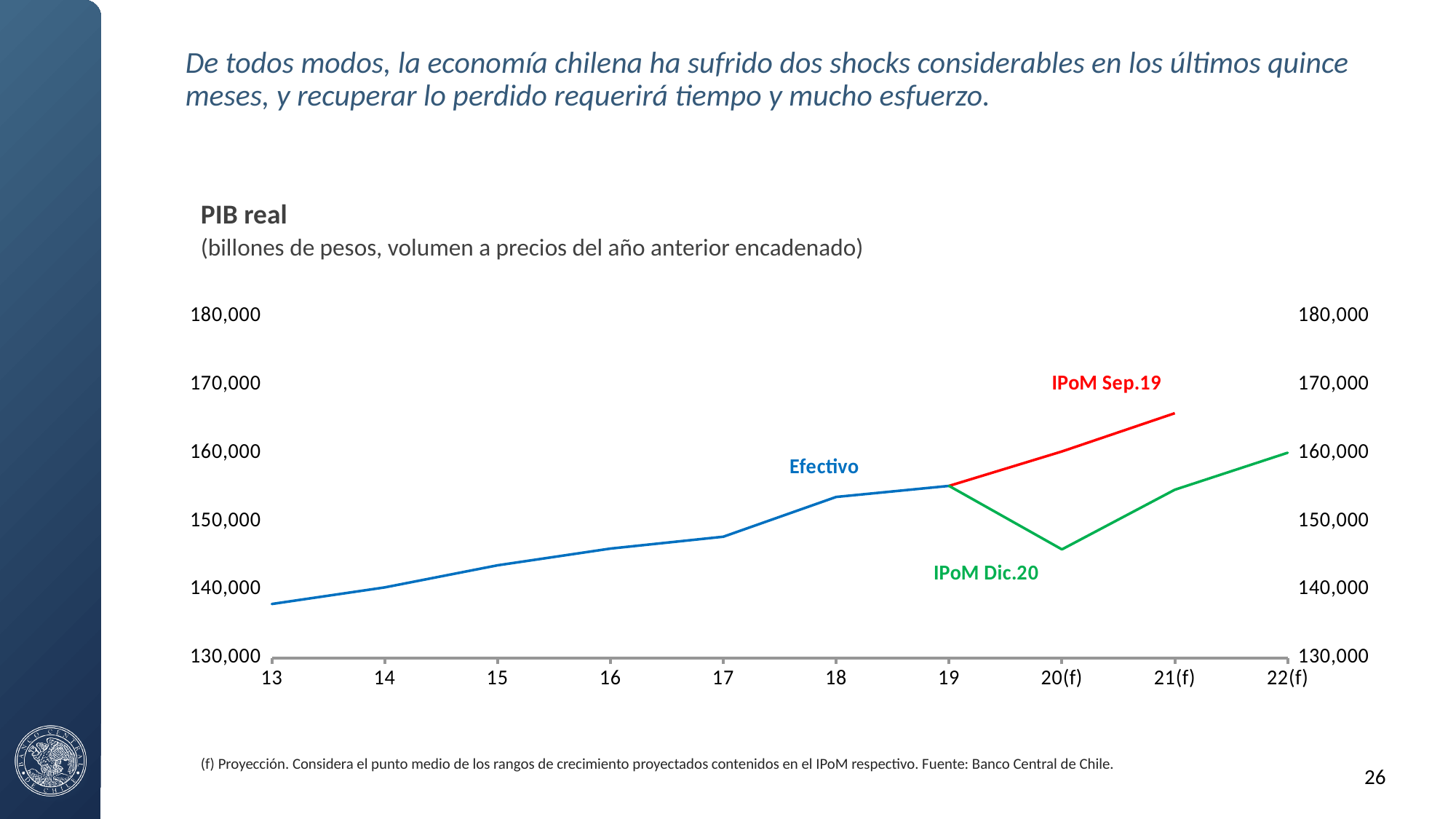
At 21(f), which is higher: IPoM Sep.19 or IPoM Dic.20? IPoM Sep.19 Is the IPoM Sep.19 value for 21(f) greater or less than 160,000? greater Is the IPoM Dic.20 value for 20(f) greater or less than 150,000? less Is the Efectivo value for 19 greater or less than 150,000? greater How many years are shown on the x axis of the chart? 10 What is the title of the chart? PIB real Does the IPoM Dic.20 line rise or fall from 19 to 20(f)? falls What kind of chart is shown on the slide? line chart How many labelled lines (series) are plotted on the chart? 3 Does the Efectivo line rise or fall from 13 to 19? rises In which year is the Efectivo line at its lowest? 13